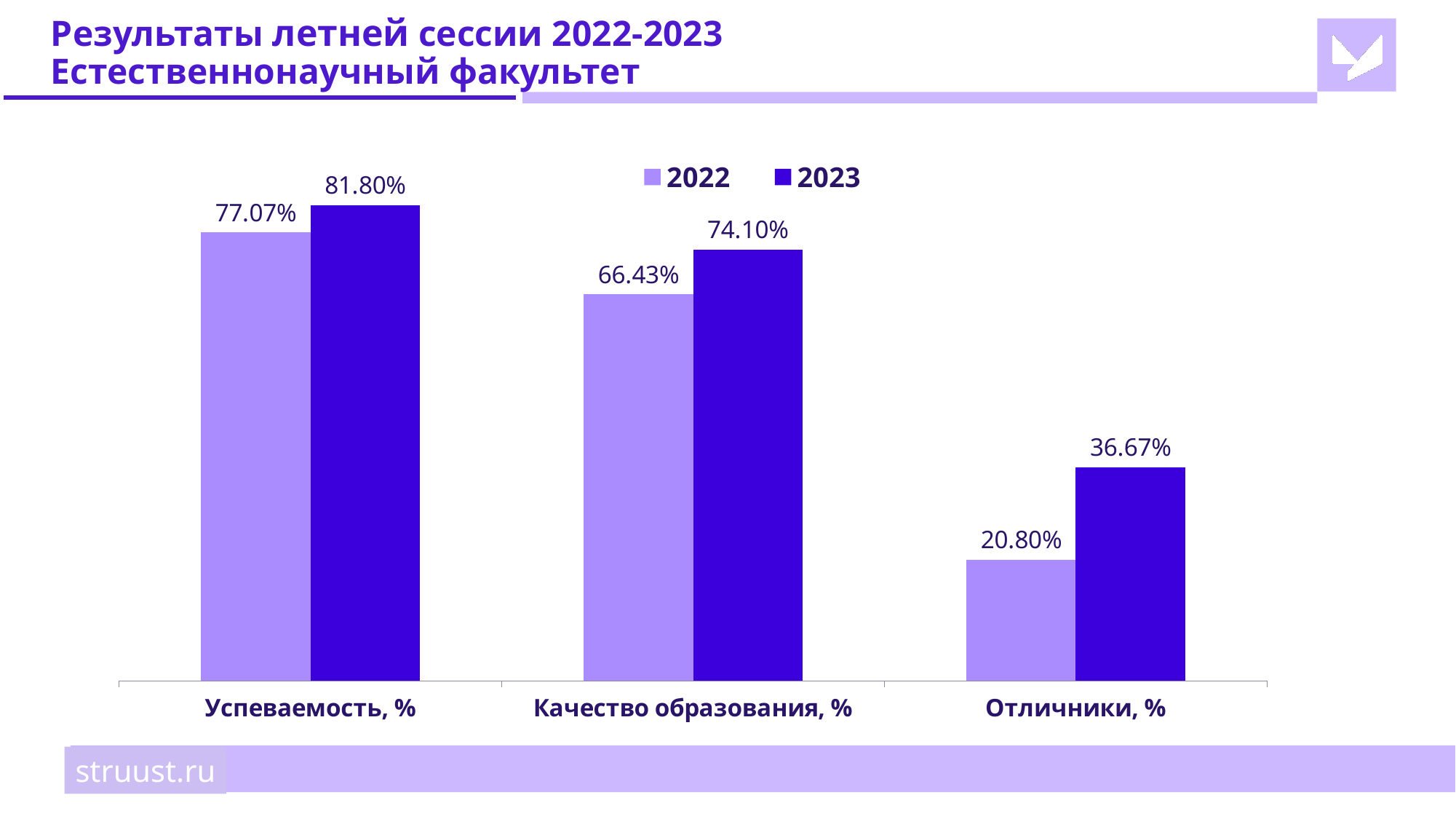
Which is larger: the 2022 value for Успеваемость, % or the 2023 value for Качество образования, %? 2022 value for Успеваемость, % Which category has the highest value for 2023? Успеваемость, % Which category has the lowest value for 2022? Отличники, % What is the value for 2023 in the Успеваемость, % category? 81.80% What is the value for 2022 in the Качество образования, % category? 66.43% What is the value for 2022 in the Отличники, % category? 20.80% How many series does the legend list? 2 Which series is shown in the darker purple colour? 2023 How many categories are shown on the x axis? 3 What is the difference between the 2023 and 2022 values in the Качество образования, % category? 7.67% What kind of chart is shown on the slide? Bar chart What is the difference between the 2023 and 2022 values in the Отличники, % category? 15.87%